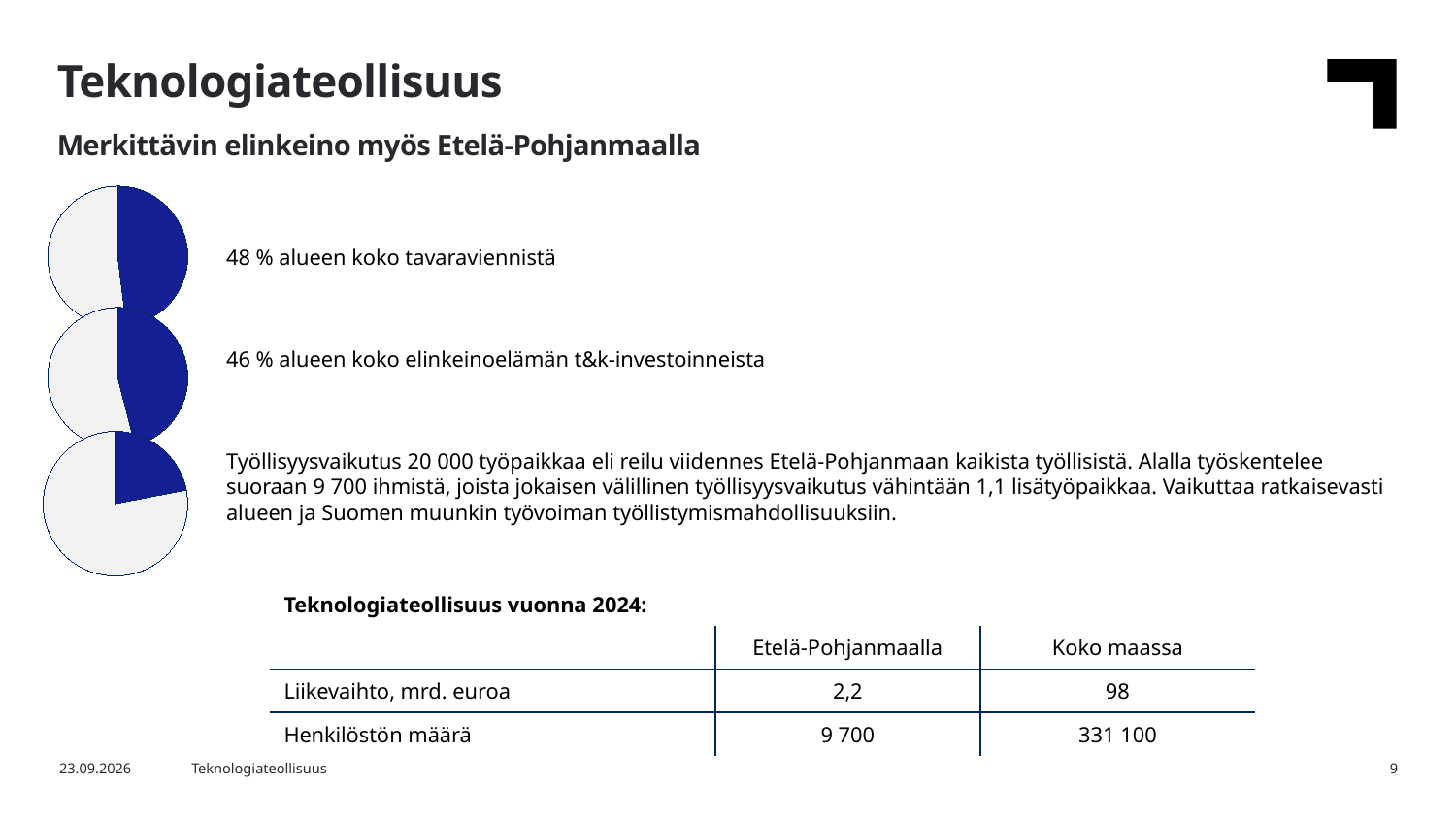
Which pie chart has the largest blue slice: the top, middle or bottom one? Top In the middle pie chart, what share of the region's business R&D investments (t&k-investoinnit) does the blue slice represent? 46 % Which is larger, the blue share in the top pie chart (goods exports) or in the middle pie chart (R&D investments)? Top pie chart (goods exports) What does the bottom pie chart illustrate, according to the text next to it? Employment impact: just over a fifth of all employed people in Etelä-Pohjanmaa What kind of chart is used on the left side of the slide? Pie chart In the top pie chart, what share of the region's total goods exports (tavaravienti) does the blue slice represent? 48 % What colour is the highlighted slice in each pie chart? Blue What is the difference in percentage points between the blue share of the top pie chart (48 %) and the middle pie chart (46 %)? 2 percentage points Which pie chart has the smallest blue slice: the top, middle or bottom one? Bottom How many pie charts are shown on the slide? 3